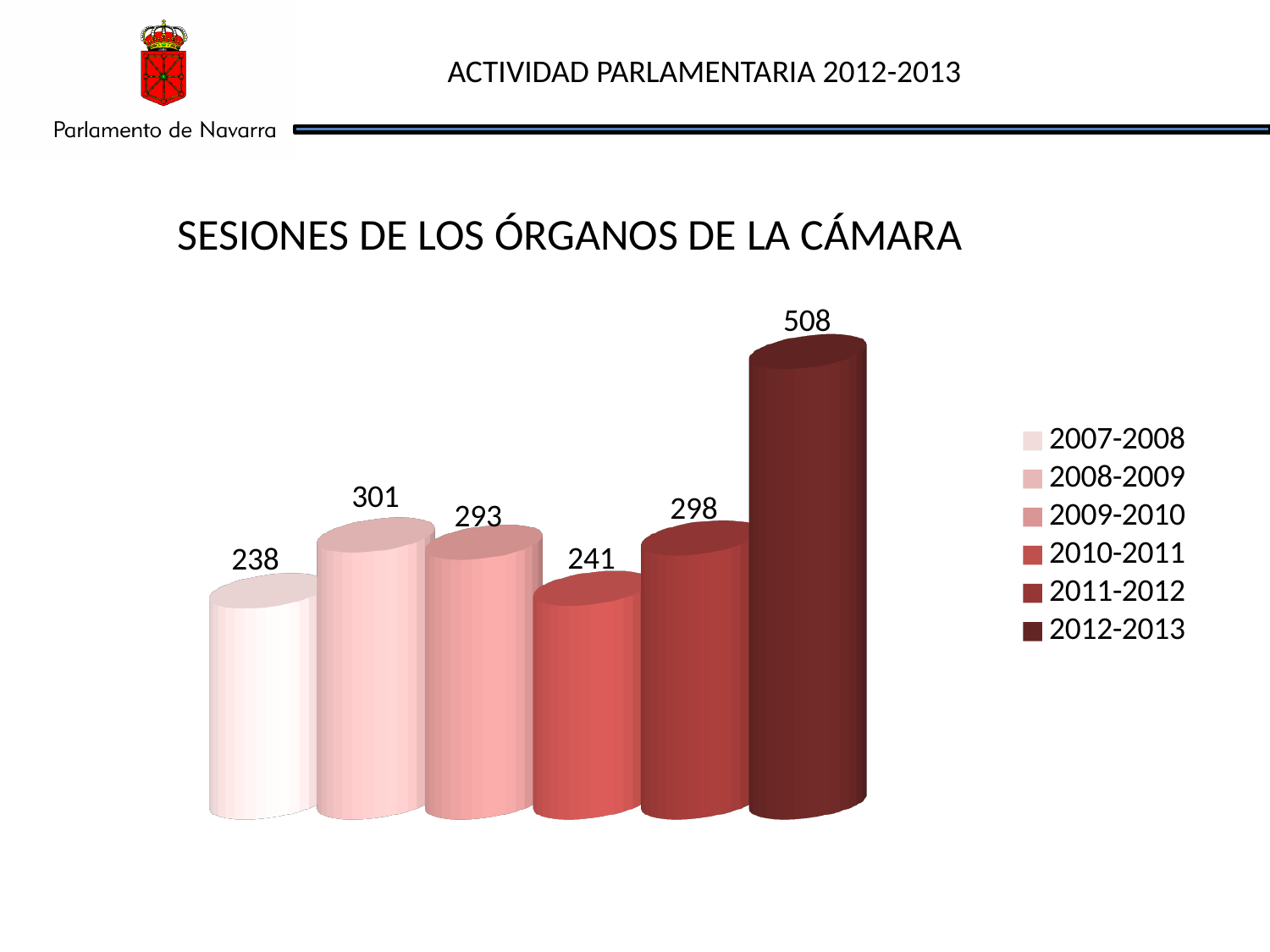
Which is larger, the value for 2010-2011 or the value for 2011-2012? 2011-2012 What is the difference between the values for 2008-2009 and 2007-2008? 63 How many bars are plotted in the chart? 6 What kind of chart is shown on the slide? Bar chart What is the value shown for 2007-2008? 238 What is the title of the chart? SESIONES DE LOS ÓRGANOS DE LA CÁMARA What is the value shown for 2012-2013? 508 What is the value shown for 2009-2010? 293 How many entries does the legend list? 6 What is the difference between the values for 2012-2013 and 2011-2012? 210 Which period has the highest number of sessions? 2012-2013 Which period has the lowest number of sessions? 2007-2008